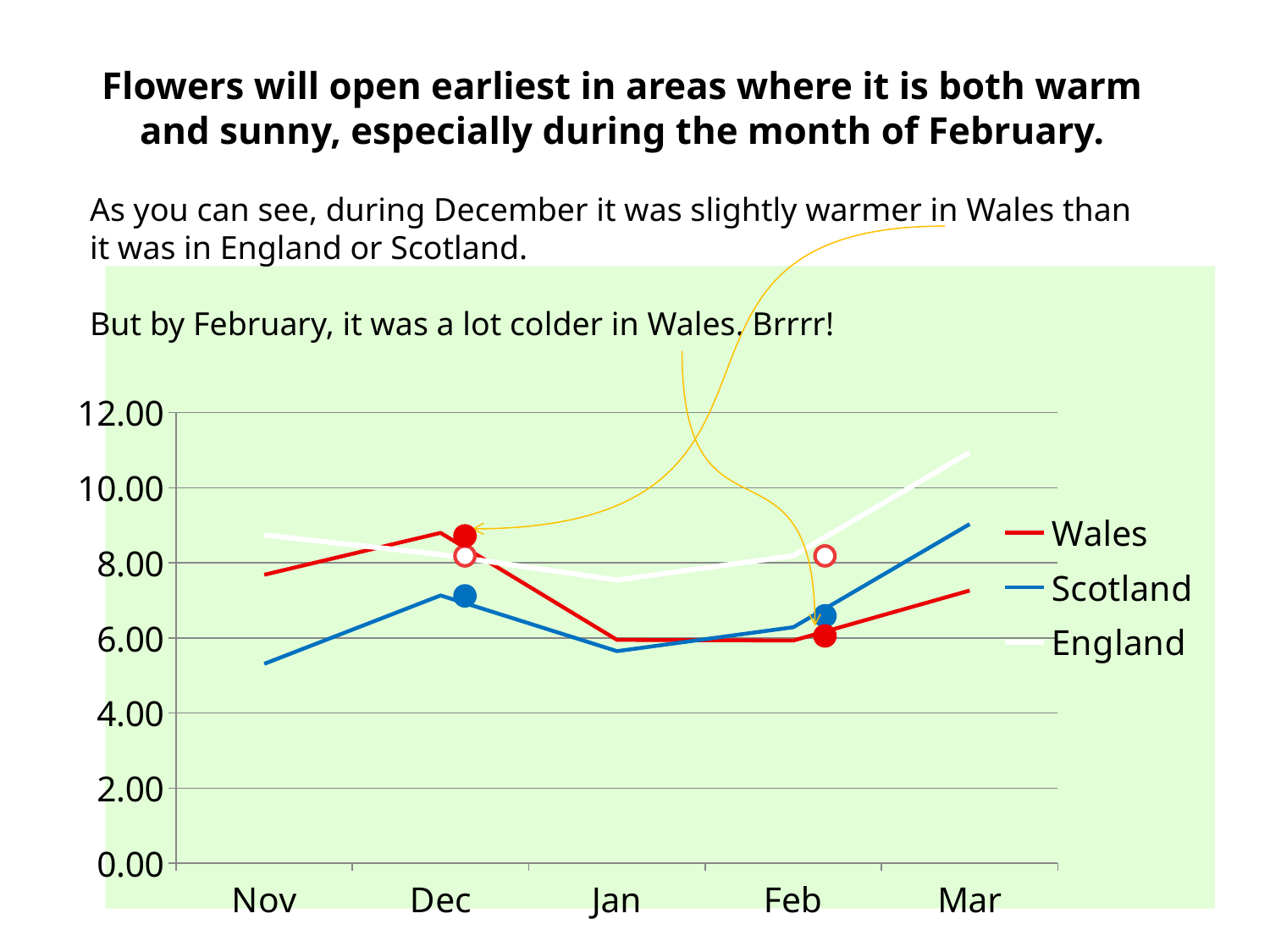
How many months are plotted along the x axis of the chart? 5 Is the value for England in Mar greater or less than 10.00? greater Is the value for Wales in Jan greater or less than 8.00? less Which series has the lowest value in Nov? Scotland In Dec, which is higher: Wales or Scotland? Wales In Feb, which is higher: England or Wales? England How many series does the chart's legend list? 3 What kind of chart is shown on the slide? line chart Is the value for Scotland in Nov greater or less than 6.00? less Which series has the highest value in Mar? England Does the Scotland line rise or fall from Feb to Mar? rise In which month does the England line reach its highest value? Mar